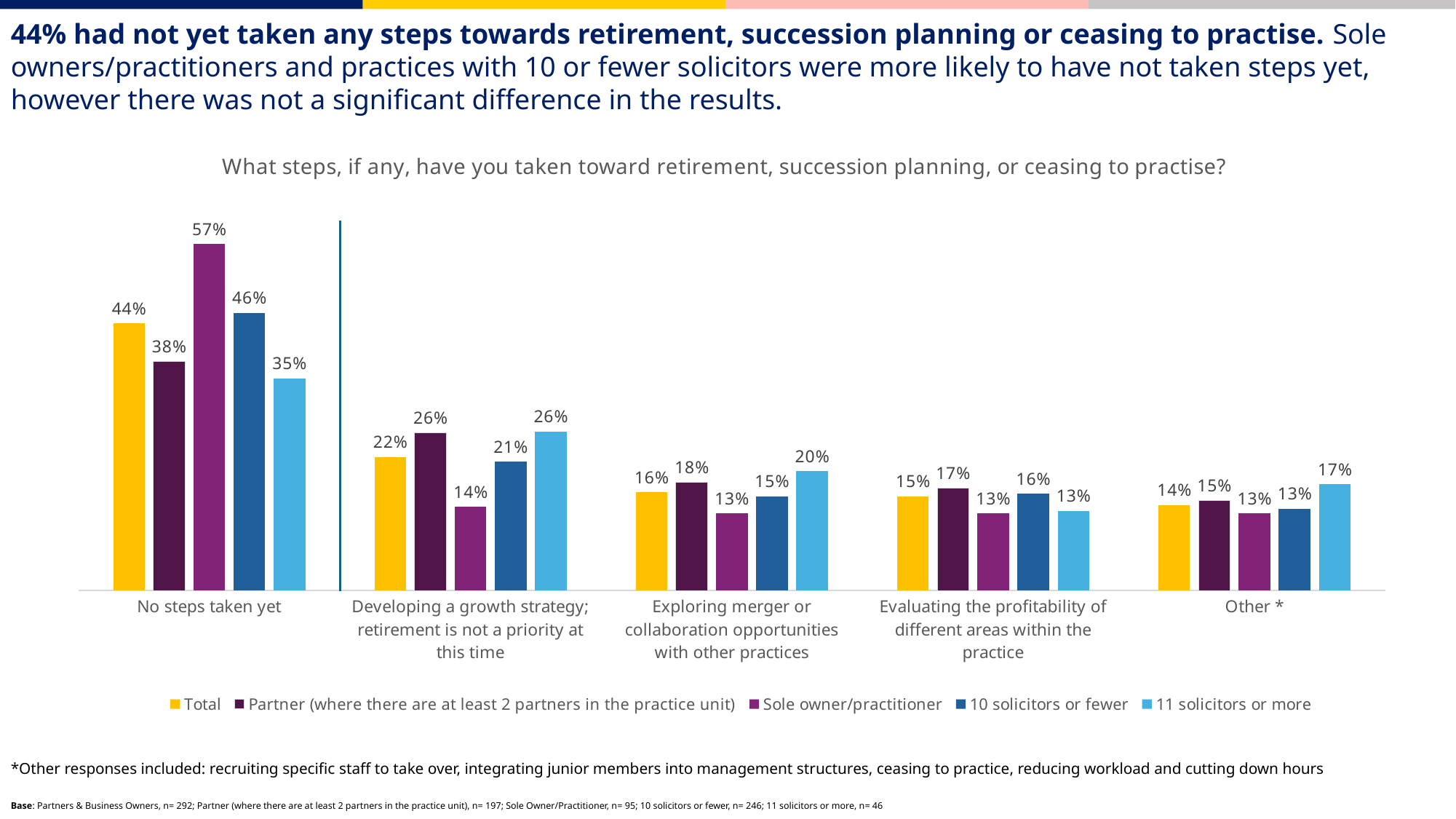
What is the difference between the Sole owner/practitioner and Partner values for 'No steps taken yet'? 19 percentage points How many series does the legend list? 5 How many response categories are shown on the x axis? 5 Which series has the highest value in the 'No steps taken yet' category? Sole owner/practitioner Which series has the lowest value in the 'Developing a growth strategy; retirement is not a priority at this time' category? Sole owner/practitioner What colour represents the Total series in the chart? Yellow What is the value for '11 solicitors or more' in the 'Exploring merger or collaboration opportunities with other practices' category? 20% What kind of chart is shown on the slide? Bar chart What is the Total value for 'No steps taken yet'? 44% Do the Total values rise or fall moving from 'No steps taken yet' to 'Other *' along the x axis? Fall In the 'Other *' category, which is larger: the value for '11 solicitors or more' or the value for '10 solicitors or fewer'? 11 solicitors or more What is the value for Sole owner/practitioner in the 'No steps taken yet' category? 57%